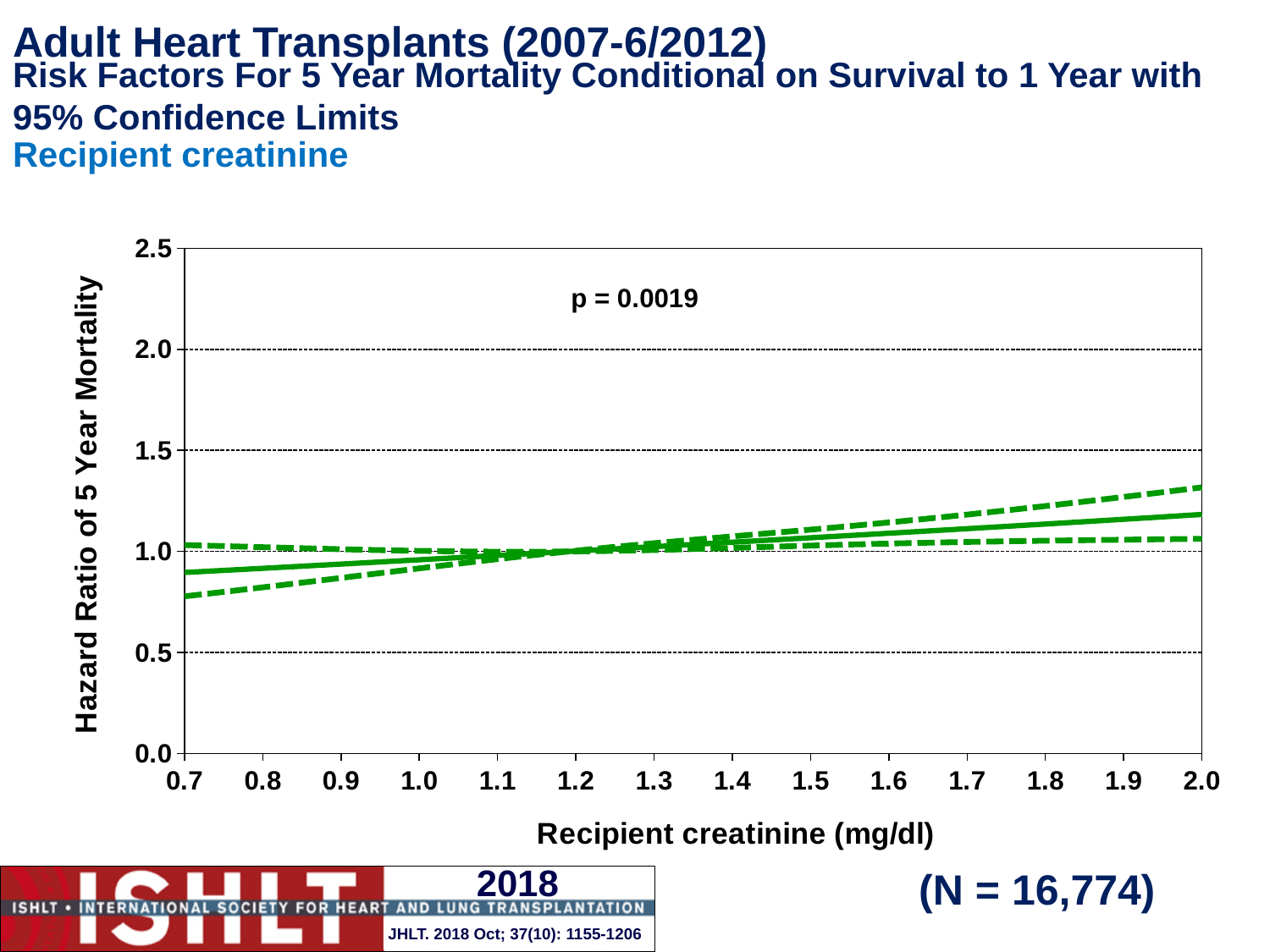
Does the hazard ratio of 5 year mortality rise or fall as recipient creatinine increases from 0.7 to 2.0 mg/dl? rise Is the hazard ratio (solid line) at a recipient creatinine of 2.0 mg/dl greater or less than 1.5? less What p-value is printed on the chart? p = 0.0019 Is the hazard ratio (solid line) higher at a recipient creatinine of 2.0 mg/dl or at 0.7 mg/dl? 2.0 mg/dl Is the lower 95% confidence limit at a recipient creatinine of 0.7 mg/dl greater or less than 0.5? greater Is the hazard ratio (solid line) at a recipient creatinine of 2.0 mg/dl greater or less than 1.0? greater What is the sample size (N) shown on the slide? N = 16,774 What kind of chart is shown on the slide? line chart